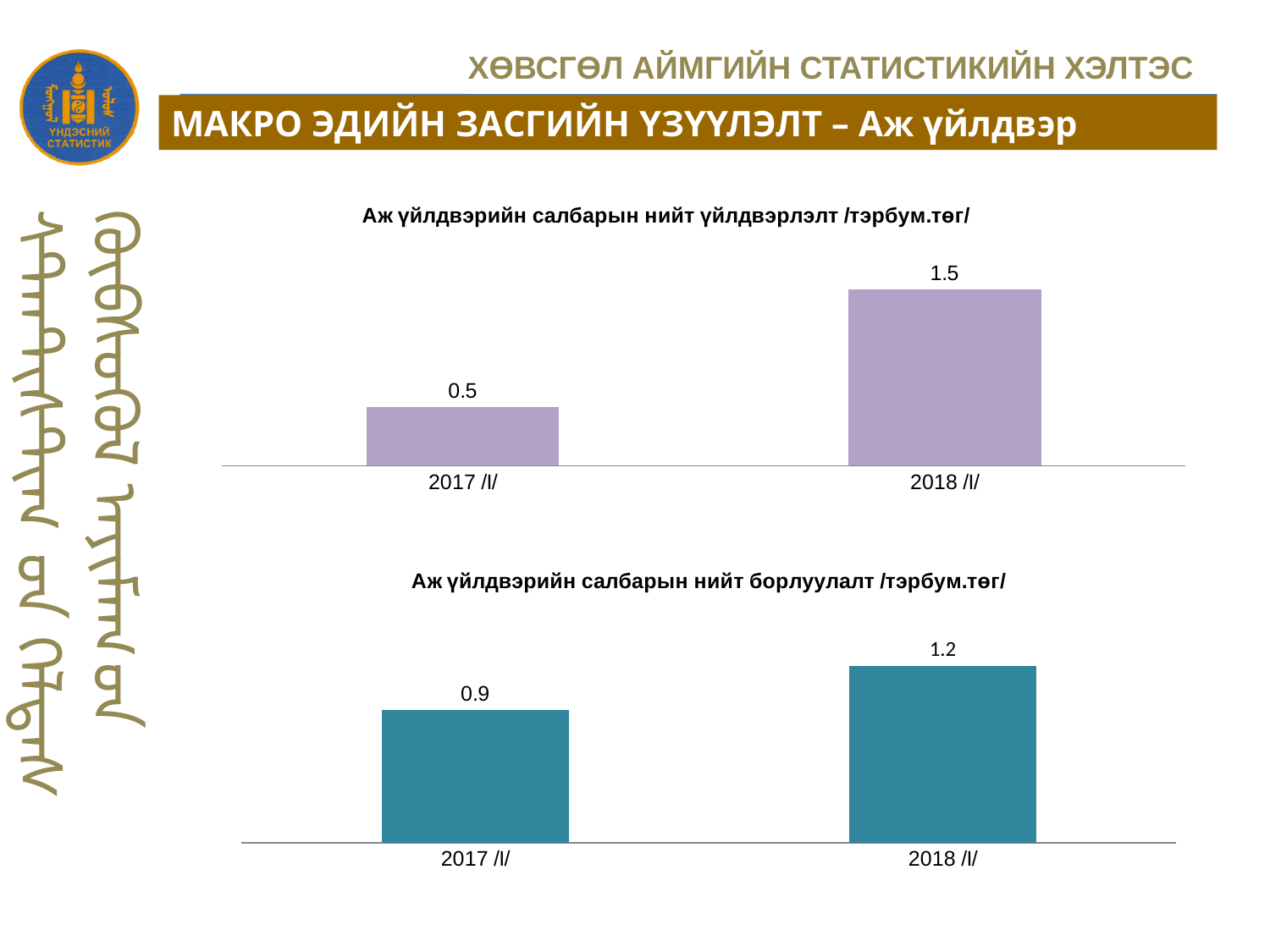
In the bottom chart (Аж үйлдвэрийн салбарын нийт борлуулалт), which year has the lower value? 2017 /I/ What type of chart is the top chart (Аж үйлдвэрийн салбарын нийт үйлдвэрлэлт)? bar chart In the top chart (Аж үйлдвэрийн салбарын нийт үйлдвэрлэлт), what is the value for 2018 /I/? 1.5 What unit is given in the title of the bottom chart (Аж үйлдвэрийн салбарын нийт борлуулалт)? тэрбум.төг In the top chart (Аж үйлдвэрийн салбарын нийт үйлдвэрлэлт), what is the value for 2017 /I/? 0.5 In the top chart (Аж үйлдвэрийн салбарын нийт үйлдвэрлэлт), how many bars are shown? 2 In the bottom chart (Аж үйлдвэрийн салбарын нийт борлуулалт), do the values rise or fall from 2017 /I/ to 2018 /I/? rise In the bottom chart (Аж үйлдвэрийн салбарын нийт борлуулалт), what is the value for 2018 /I/? 1.2 In the bottom chart (Аж үйлдвэрийн салбарын нийт борлуулалт), what is the difference between the 2018 /I/ and 2017 /I/ values? 0.3 In the top chart (Аж үйлдвэрийн салбарын нийт үйлдвэрлэлт), which year has the higher value? 2018 /I/ In the top chart (Аж үйлдвэрийн салбарын нийт үйлдвэрлэлт), what is the difference between the 2018 /I/ and 2017 /I/ values? 1.0 In the bottom chart (Аж үйлдвэрийн салбарын нийт борлуулалт), what is the value for 2017 /I/? 0.9